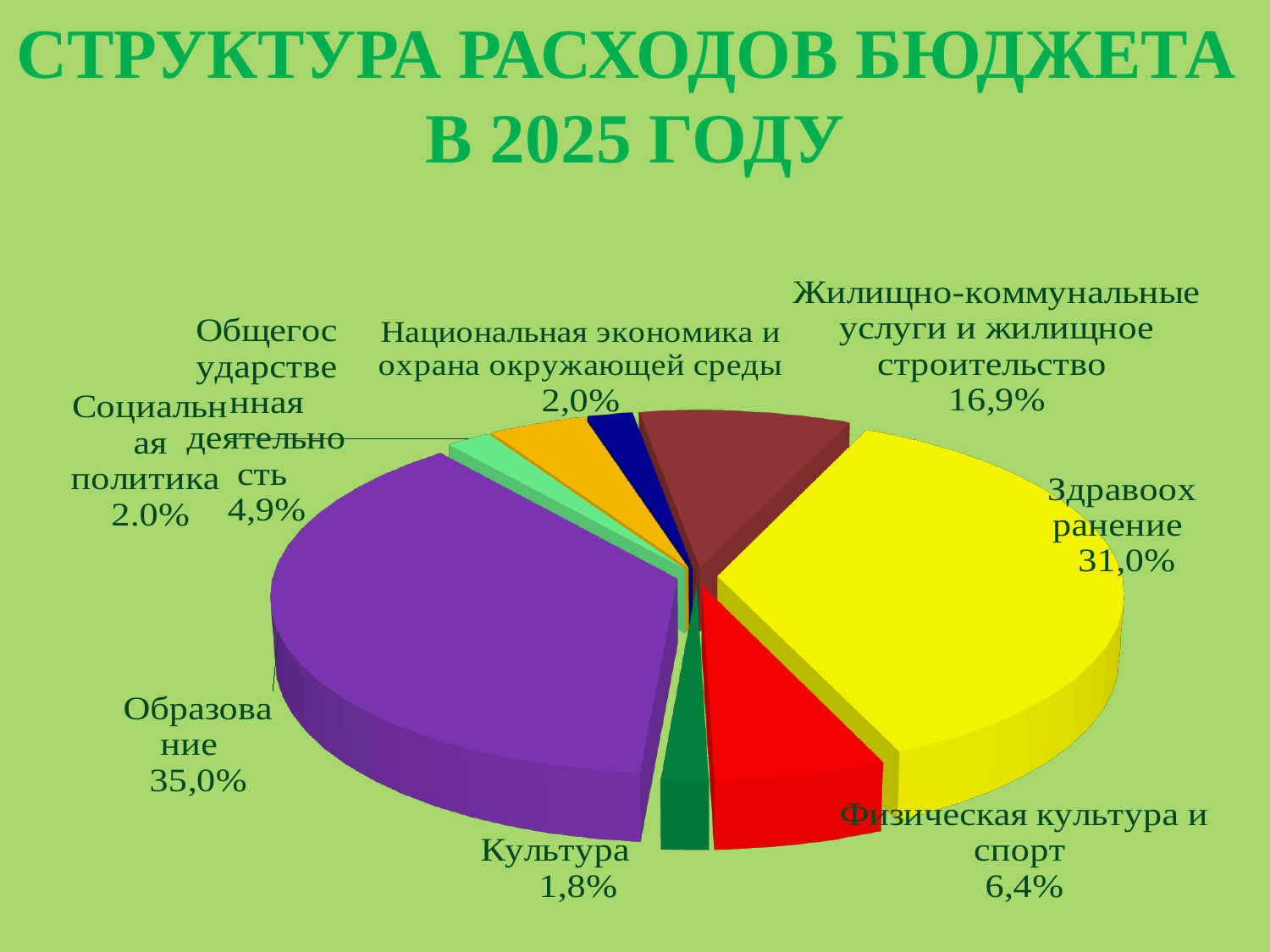
How many categories are shown in the pie chart? 8 Which category has the smallest share of the budget? Культура What kind of chart is shown on the slide? pie chart Which is larger: the share for Физическая культура и спорт or the share for Общегосударственная деятельность? Физическая культура и спорт What share is shown for Жилищно-коммунальные услуги и жилищное строительство? 16,9% What share of budget expenditure goes to Образование? 35,0% What share is shown for Культура? 1,8% What share of budget expenditure goes to Здравоохранение? 31,0% Which category has the largest share of the budget? Образование What is the title of the slide? СТРУКТУРА РАСХОДОВ БЮДЖЕТА В 2025 ГОДУ What share is shown for Физическая культура и спорт? 6,4% What is the difference in percentage points between Образование and Здравоохранение? 4,0%